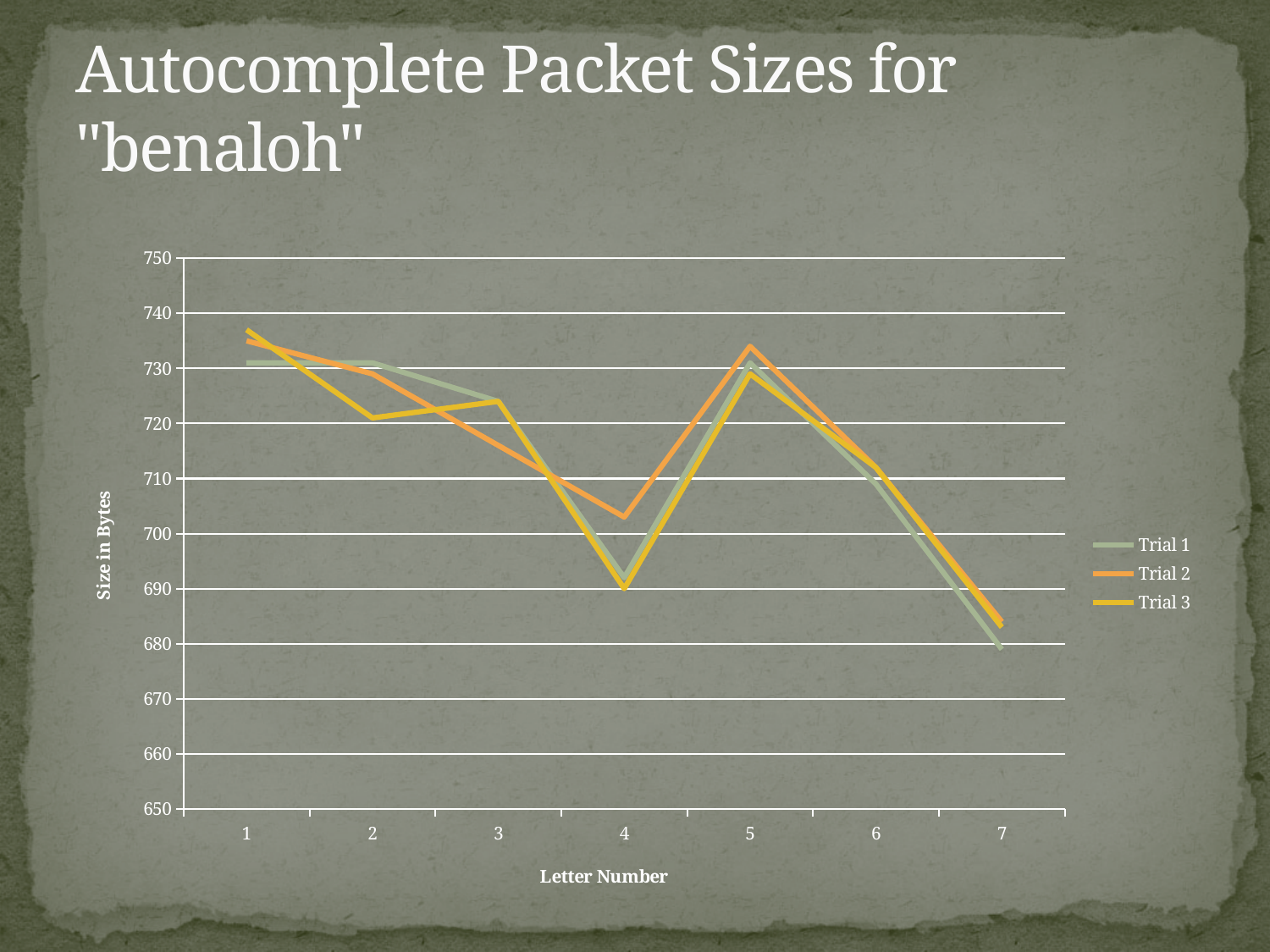
What is the title of the y axis? Size in Bytes Overall, do the packet sizes rise or fall from letter number 1 to letter number 7? fall How many letter numbers are plotted along the x axis? 7 At letter number 4, which is larger: Trial 1 or Trial 2? Trial 2 What kind of chart is shown on the slide? line chart At which letter number is Trial 3 at its highest? 1 Is the value for Trial 3 at letter number 2 greater or less than 730? less Is the value for Trial 1 at letter number 4 greater or less than 700? less At which letter number is Trial 1 at its lowest? 7 Is the value for Trial 2 at letter number 1 greater or less than 730? greater How many series does the legend list? 3